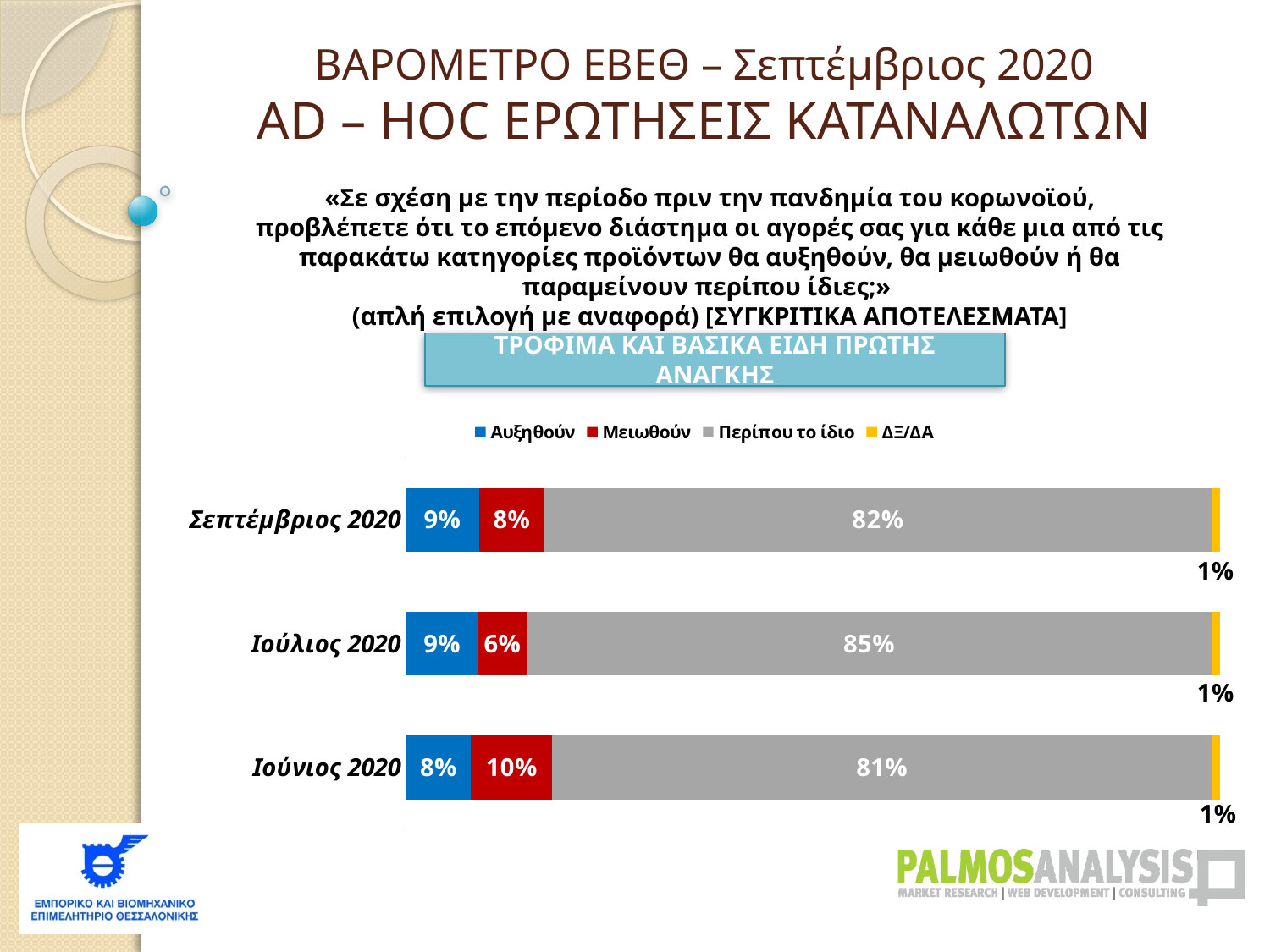
What is the value of ΔΞ/ΔΑ for Ιούλιος 2020? 1% What type of chart is shown on the slide? Stacked bar chart What is the value of Μειωθούν for Ιούλιος 2020? 6% Which is larger: Μειωθούν for Ιούνιος 2020 or Μειωθούν for Σεπτέμβριος 2020? Ιούνιος 2020 What is the title shown above the chart? ΤΡΟΦΙΜΑ ΚΑΙ ΒΑΣΙΚΑ ΕΙΔΗ ΠΡΩΤΗΣ ΑΝΑΓΚΗΣ What is the difference between the Περίπου το ίδιο values for Ιούλιος 2020 and Ιούνιος 2020? 4% How many series does the legend list? 4 What is the value of Περίπου το ίδιο for Σεπτέμβριος 2020? 82% Which period has the lowest value for Μειωθούν? Ιούλιος 2020 Which period has the highest value for Περίπου το ίδιο? Ιούλιος 2020 How many categories (time periods) are shown on the chart? 3 What is the value of Αυξηθούν for Ιούνιος 2020? 8%